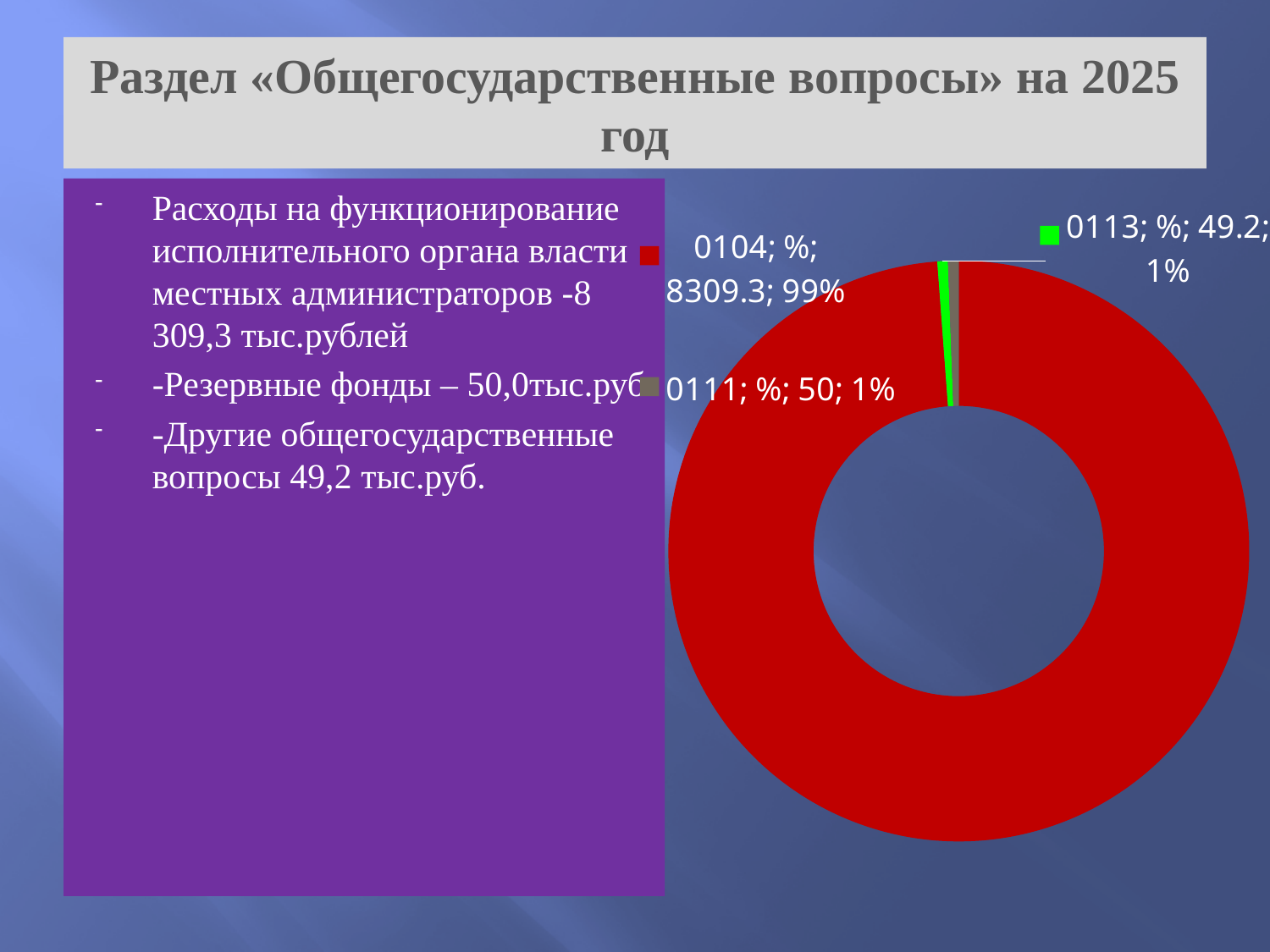
What colour is the slice for category 0104? red Which is larger, the value for 0111 or the value for 0113? 0111 What value is shown for category 0113? 49.2 What kind of chart is shown on the slide? doughnut chart What value is shown for category 0104? 8309.3 Which category has the largest value? 0104 What value is shown for category 0111? 50 How many slices does the chart have? 3 Which category has the smallest value? 0113 What is the difference between the values for 0104 and 0111? 8259.3 What share of the chart does category 0113 represent? 1% What share of the chart does category 0104 represent? 99%